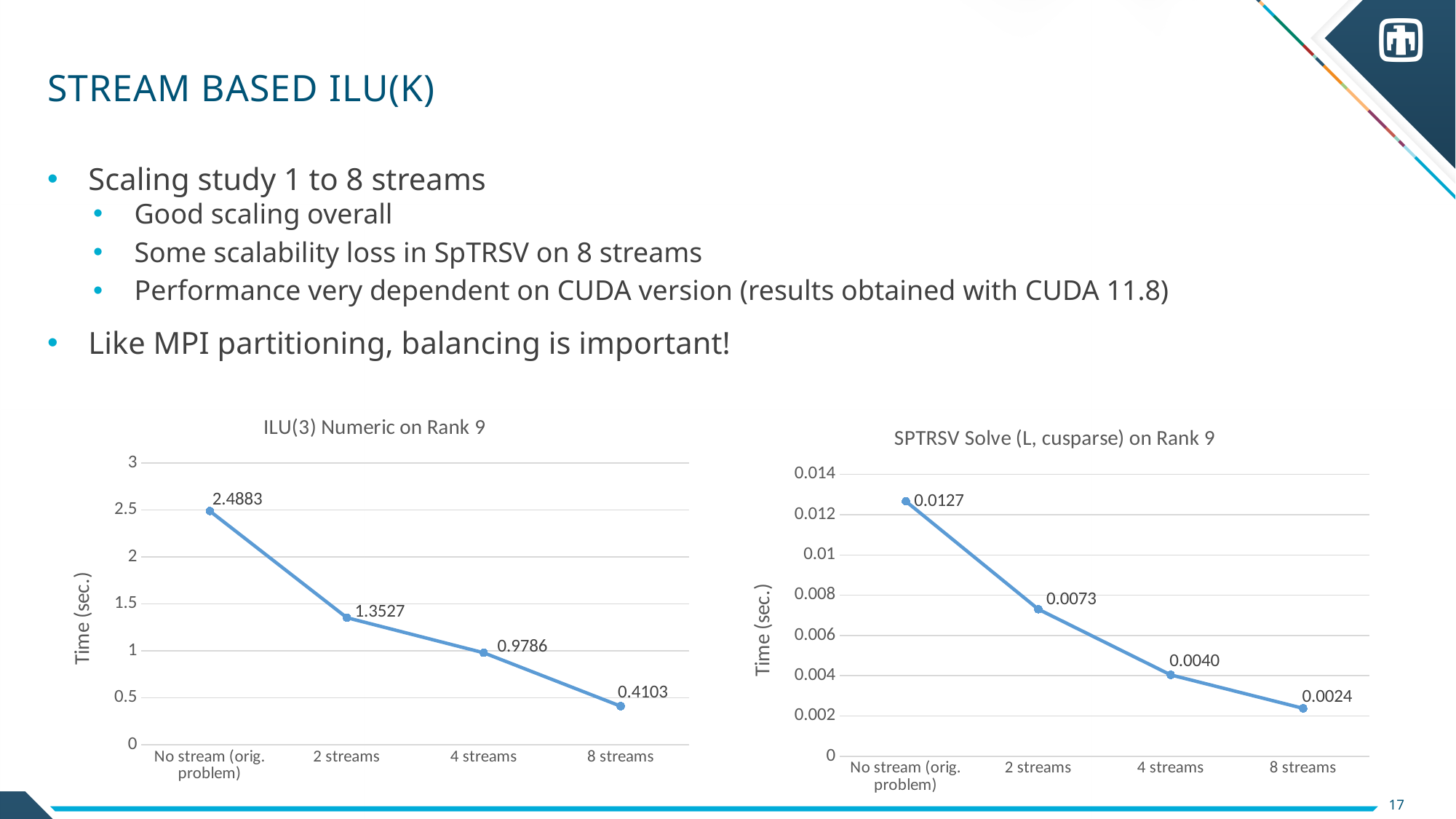
In the 'SPTRSV Solve (L, cusparse) on Rank 9' chart, what is the difference between the time for No stream (orig. problem) and the time for 2 streams? 0.0054 In the 'SPTRSV Solve (L, cusparse) on Rank 9' chart, what is the time for 4 streams? 0.0040 How many data points are plotted in the 'ILU(3) Numeric on Rank 9' chart? 4 In the 'SPTRSV Solve (L, cusparse) on Rank 9' chart, is the value for 2 streams greater or less than 0.008? less What is the y-axis label of the 'SPTRSV Solve (L, cusparse) on Rank 9' chart? Time (sec.) In the 'ILU(3) Numeric on Rank 9' chart, what is the time for 2 streams? 1.3527 In the 'SPTRSV Solve (L, cusparse) on Rank 9' chart, which category has the lowest time? 8 streams What kind of chart is the 'SPTRSV Solve (L, cusparse) on Rank 9' chart? line chart In the 'ILU(3) Numeric on Rank 9' chart, what is the difference between the time for No stream (orig. problem) and the time for 8 streams? 2.0780 In the 'ILU(3) Numeric on Rank 9' chart, do the values rise or fall as the number of streams increases? fall In the 'ILU(3) Numeric on Rank 9' chart, which is larger: the time for 2 streams or the time for 4 streams? 2 streams In the 'ILU(3) Numeric on Rank 9' chart, which category has the highest time? No stream (orig. problem)